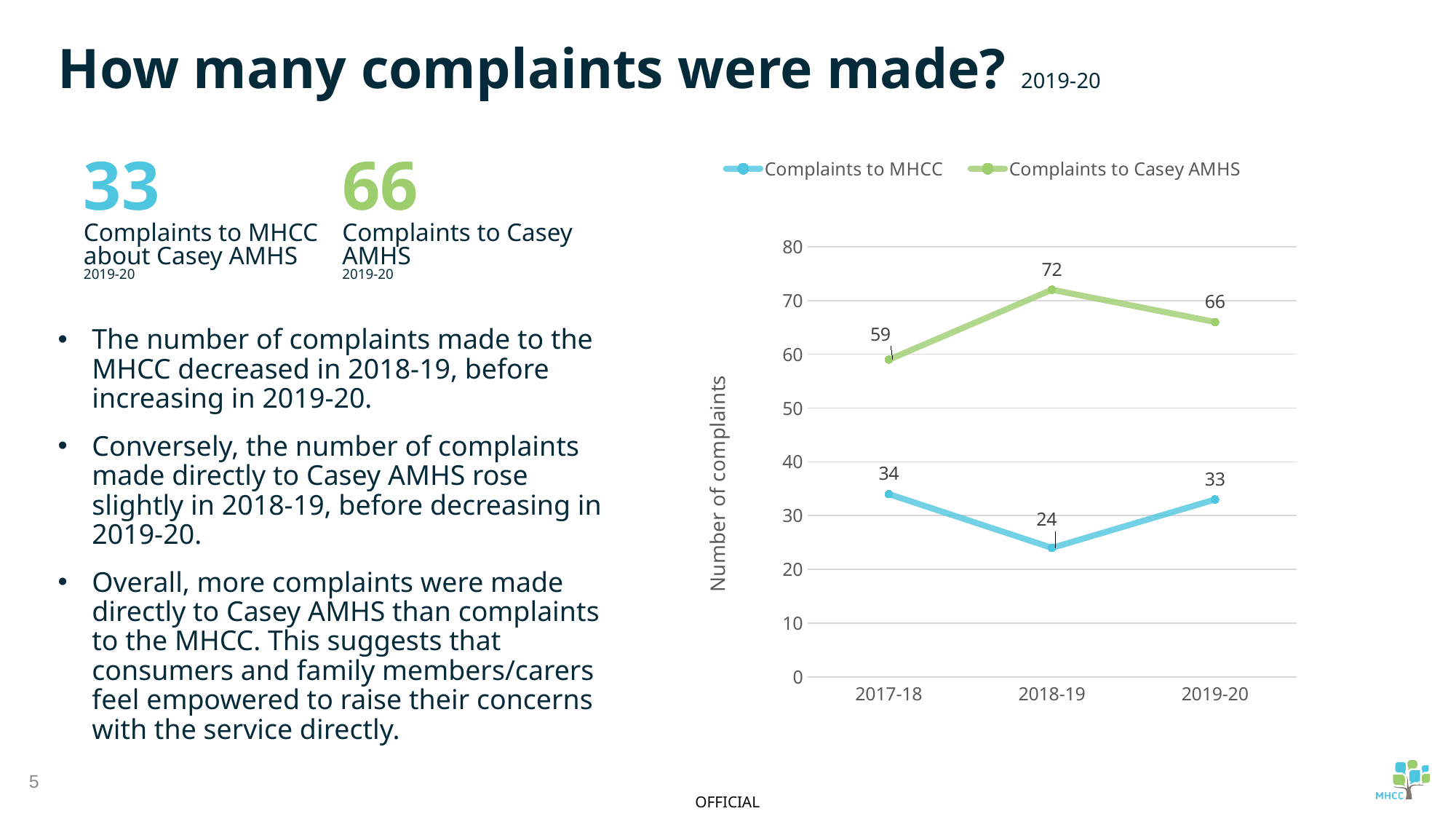
What is the value for Complaints to MHCC in 2018-19? 24 What is the value for Complaints to Casey AMHS in 2019-20? 66 How many points along the x axis does the chart show? 3 How many series does the chart legend list? 2 In which year is the value for Complaints to Casey AMHS highest? 2018-19 Does the value for Complaints to MHCC rise or fall from 2018-19 to 2019-20? rise What is the label on the vertical axis of the chart? Number of complaints Which series has the larger value in 2017-18, Complaints to MHCC or Complaints to Casey AMHS? Complaints to Casey AMHS What is the value for Complaints to Casey AMHS in 2017-18? 59 In which year is the value for Complaints to MHCC lowest? 2018-19 What is the difference between Complaints to Casey AMHS and Complaints to MHCC in 2019-20? 33 What kind of chart is shown on the slide? line chart